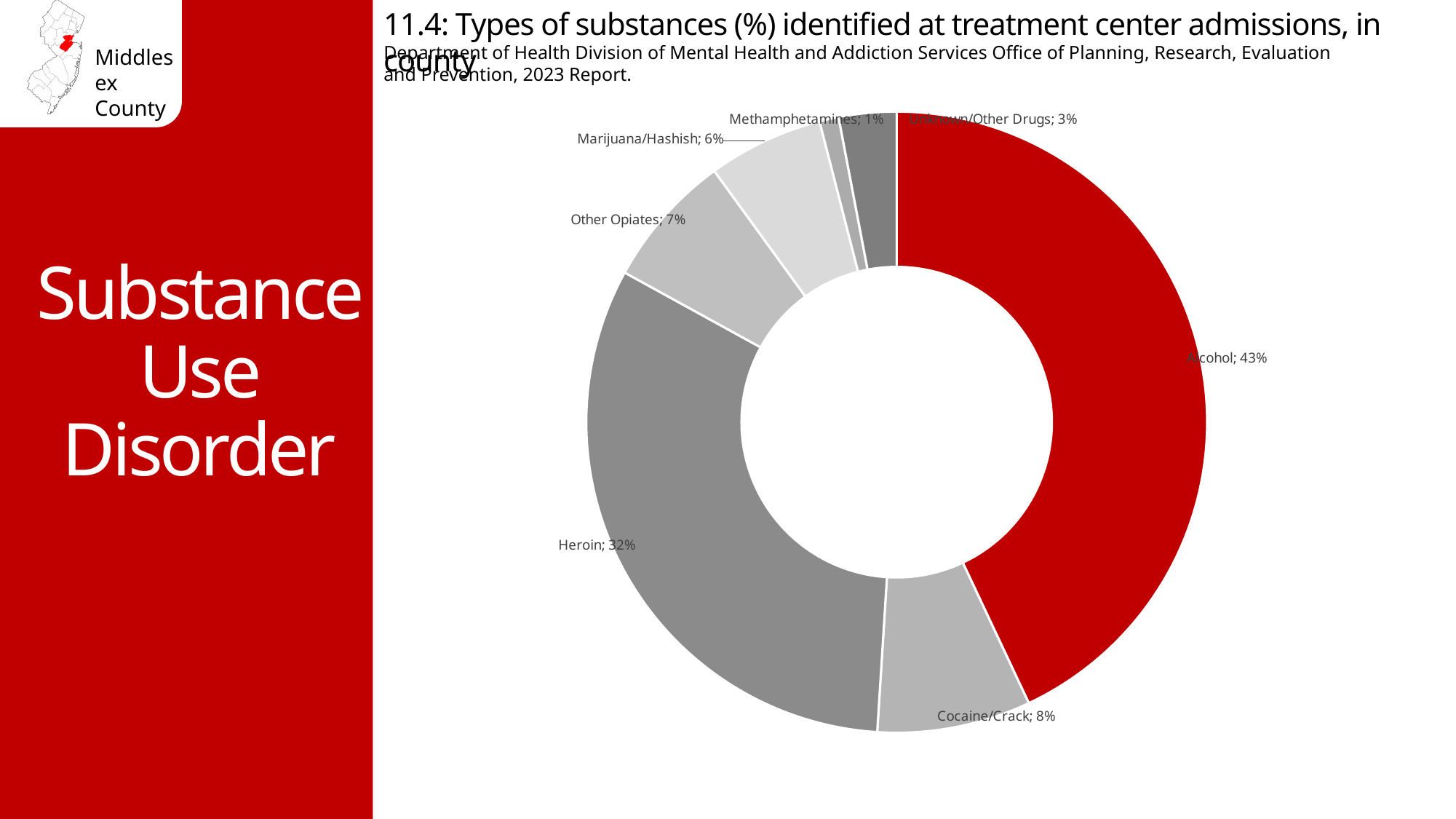
Which substance has the largest share of admissions? Alcohol Which substance has the smallest share of admissions? Methamphetamines What percentage is shown for Heroin? 32% What percentage of treatment center admissions is attributed to Alcohol? 43% What is the value shown for Cocaine/Crack? 8% What percentage is shown for Methamphetamines? 1% What is the difference in percentage points between Alcohol and Heroin? 11 How many substance categories are shown in the chart? 7 Which has a larger share, Marijuana/Hashish or Unknown/Other Drugs? Marijuana/Hashish What kind of chart is used on this slide? Doughnut (pie) chart What is the combined share of Alcohol and Heroin? 75% What percentage is shown for Other Opiates? 7%